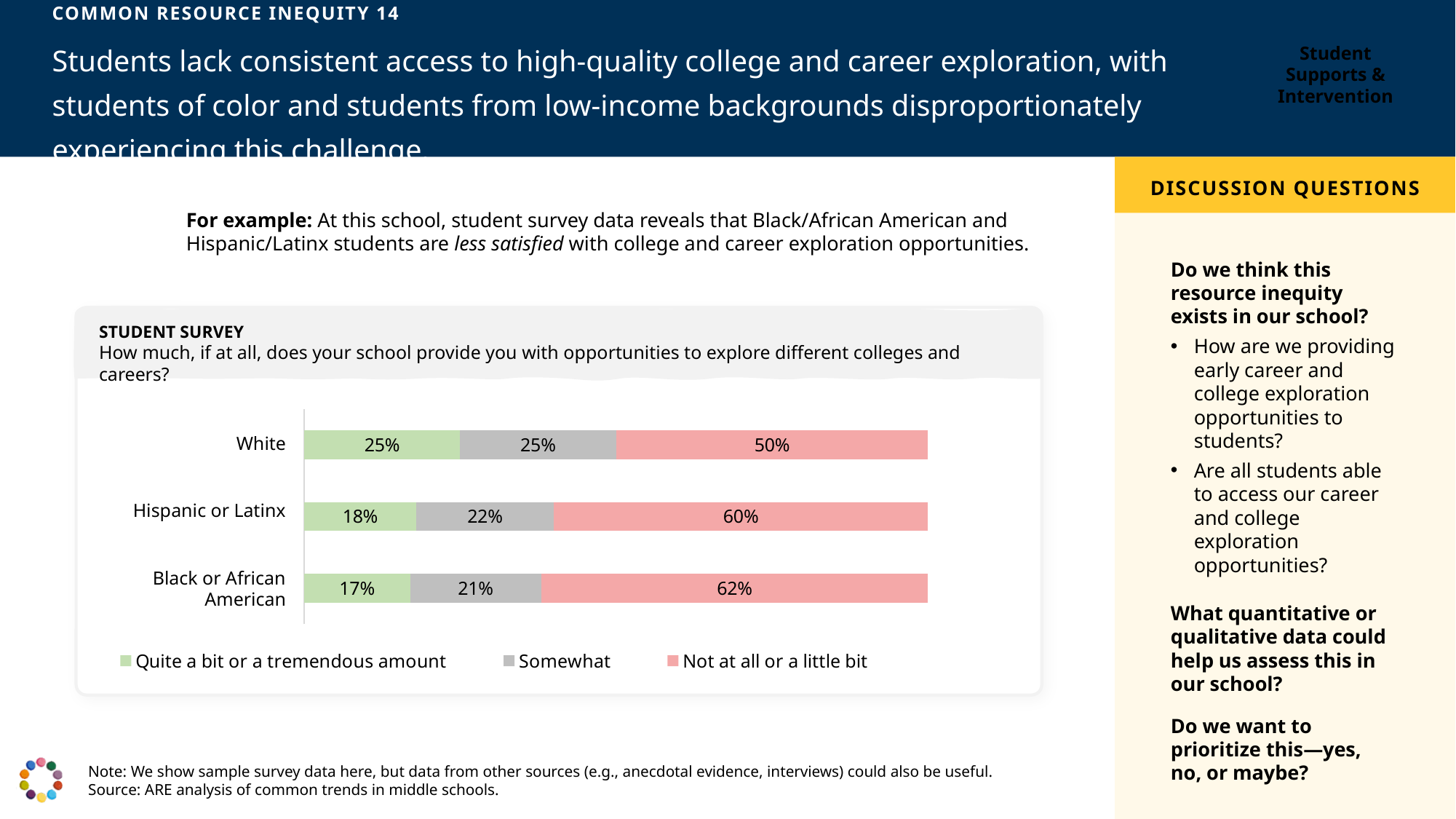
What is the difference between the "Not at all or a little bit" share for Black or African American students and for White students? 12 percentage points How many student groups are shown in the chart? 3 What kind of chart is shown on the slide? Stacked bar chart What percentage of White students answered "Not at all or a little bit"? 50% What is the total of the three segments for the Hispanic or Latinx bar? 100% What percentage of Hispanic or Latinx students answered "Somewhat"? 22% What percentage of Black or African American students answered "Quite a bit or a tremendous amount"? 17% Which group has the highest share answering "Not at all or a little bit"? Black or African American Which is larger: the "Quite a bit or a tremendous amount" share for White students or for Hispanic or Latinx students? White How many response categories does the legend list? 3 Which colour represents the "Somewhat" response in the chart? Gray Which group has the lowest share answering "Quite a bit or a tremendous amount"? Black or African American